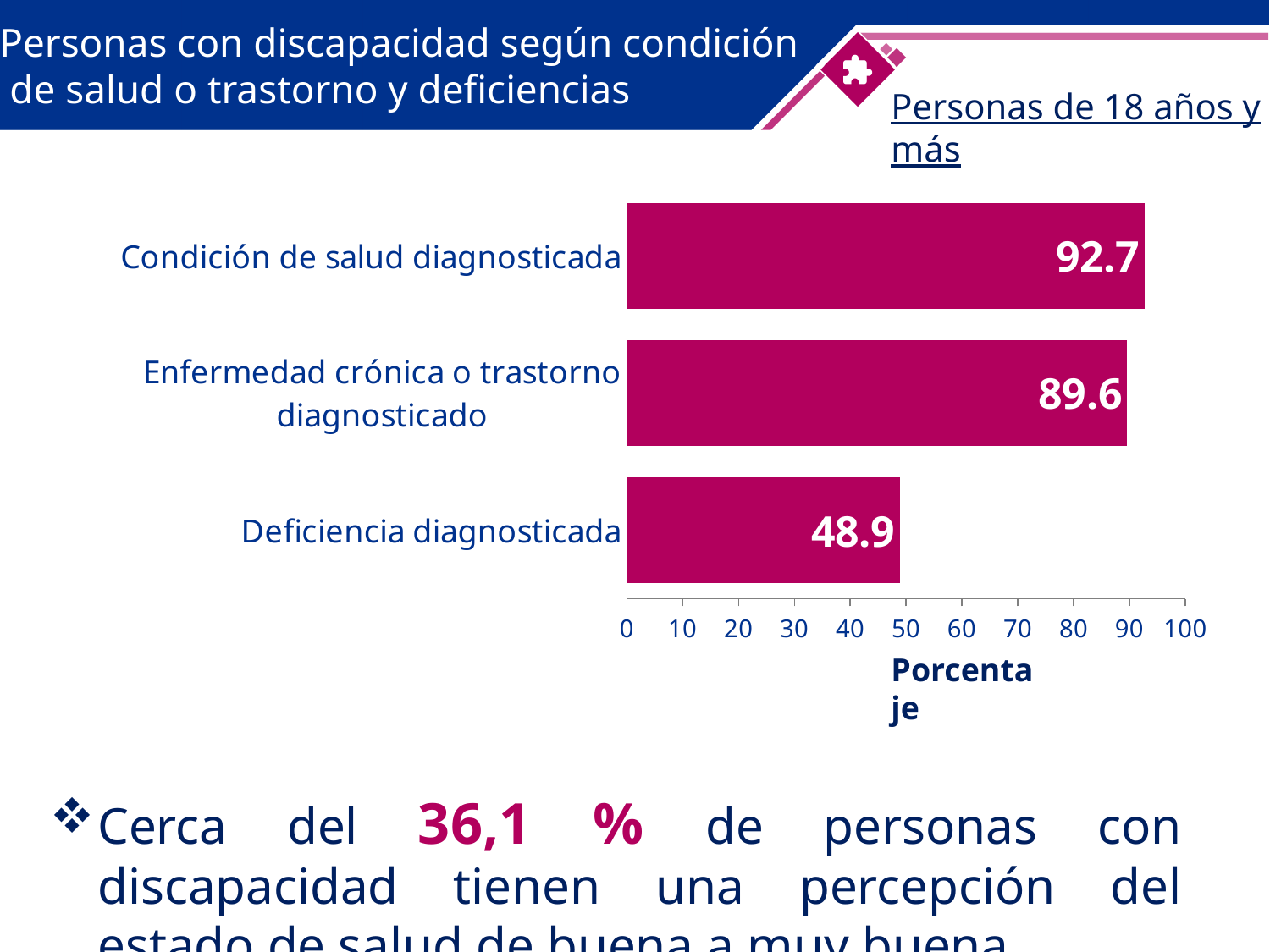
What kind of chart is shown on the slide? bar chart How many categories are shown in the chart? 3 What is the label of the horizontal axis? Porcentaje Is the value for Deficiencia diagnosticada greater or less than 50? less What is the value for Deficiencia diagnosticada? 48.9 What is the difference between the values for Condición de salud diagnosticada and Enfermedad crónica o trastorno diagnosticado? 3.1 What is the value for Condición de salud diagnosticada? 92.7 What is the difference between the values for Condición de salud diagnosticada and Deficiencia diagnosticada? 43.8 Which category has the lowest value? Deficiencia diagnosticada Which is larger, the value for Enfermedad crónica o trastorno diagnosticado or the value for Deficiencia diagnosticada? Enfermedad crónica o trastorno diagnosticado What is the value for Enfermedad crónica o trastorno diagnosticado? 89.6 Which category has the highest value? Condición de salud diagnosticada